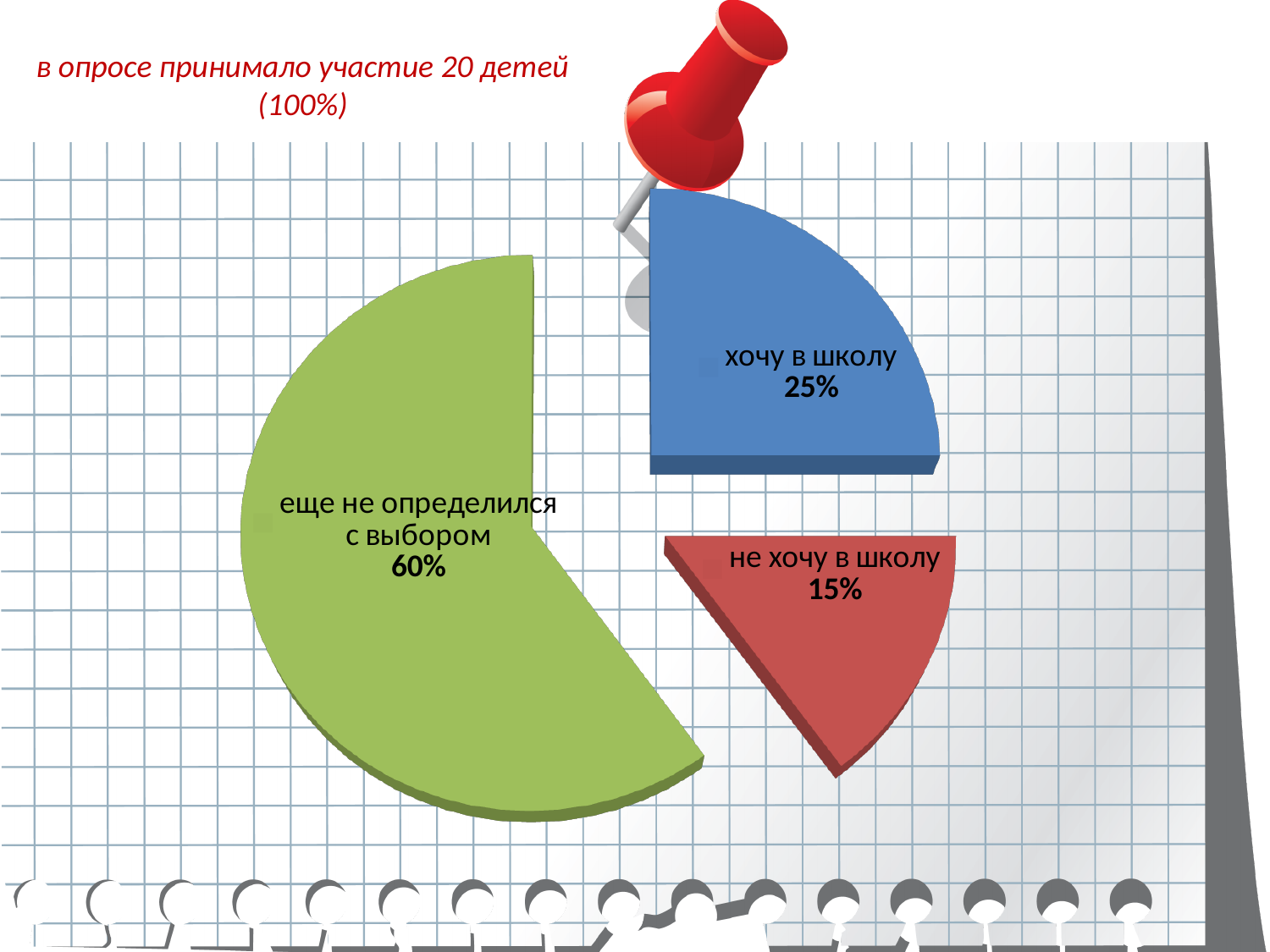
What kind of chart is shown on the slide? pie chart What share of the pie is labelled "хочу в школу"? 25% Which slice of the pie chart is the largest? еще не определился с выбором What colour is the slice labelled "не хочу в школу"? red How many slices does the pie chart have? 3 According to the text above the chart, how many children took part in the survey? 20 Which slice of the pie chart is the smallest? не хочу в школу What is the difference in percentage points between "хочу в школу" and "не хочу в школу"? 10% Which is larger: the share for "хочу в школу" or the share for "не хочу в школу"? хочу в школу What share of the pie is labelled "не хочу в школу"? 15% What is the difference in percentage points between "еще не определился с выбором" and "хочу в школу"? 35% What share of the pie is labelled "еще не определился с выбором"? 60%